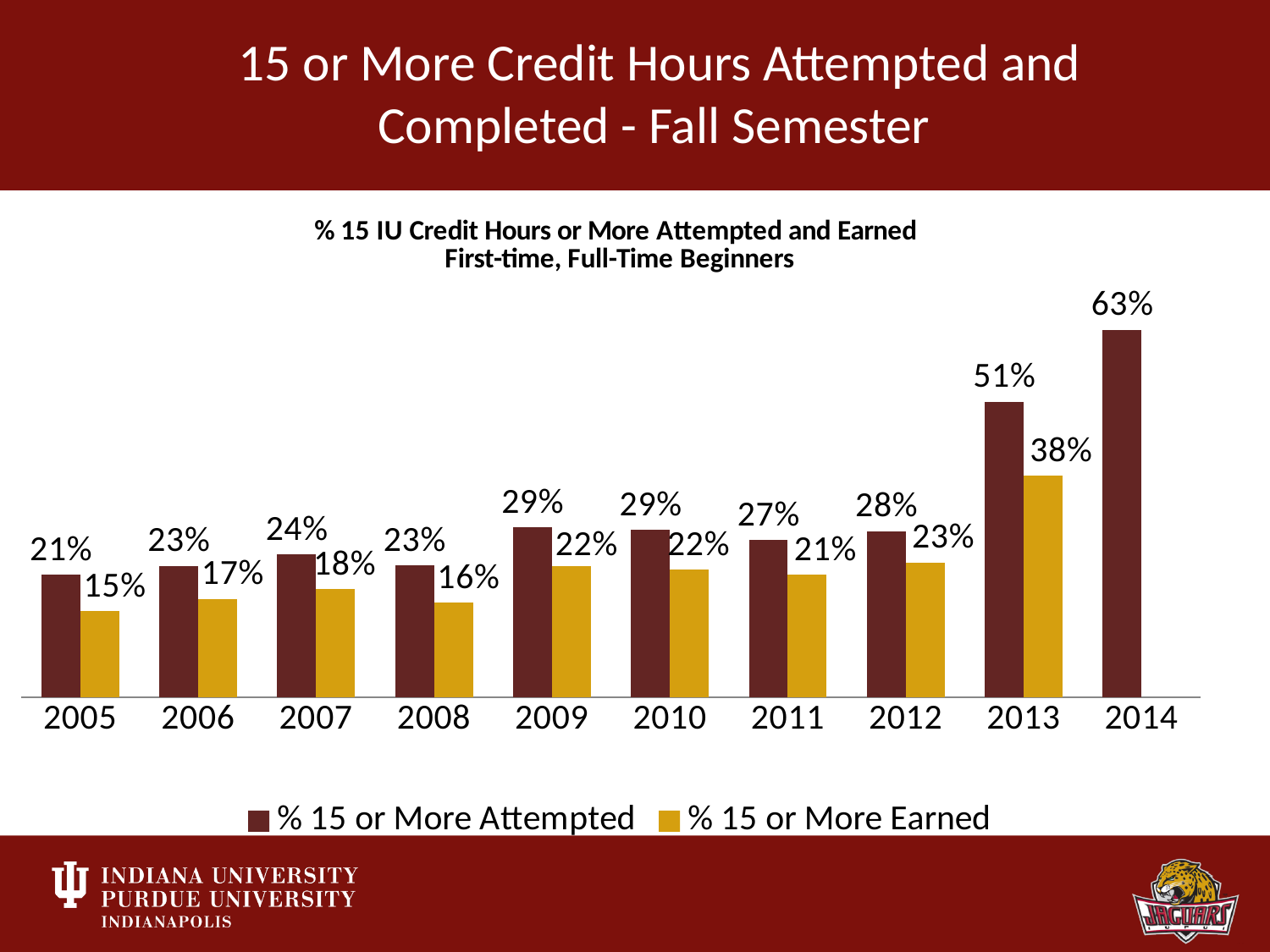
How many years are shown on the x axis? 10 Which year has the highest value for % 15 or More Attempted? 2014 What is the value for % 15 or More Earned in 2005? 15% What is the difference between % 15 or More Attempted and % 15 or More Earned in 2013? 13% What kind of chart is shown on the slide? Bar chart What is the value for % 15 or More Earned in 2013? 38% How many series does the legend list? 2 What is the value for % 15 or More Attempted in 2014? 63% Which year has the lowest value for % 15 or More Earned? 2005 Which series is shown in gold/yellow in the legend? % 15 or More Earned What is the difference between the % 15 or More Attempted values for 2014 and 2013? 12% Which is larger, % 15 or More Earned in 2012 or % 15 or More Earned in 2011? 2012